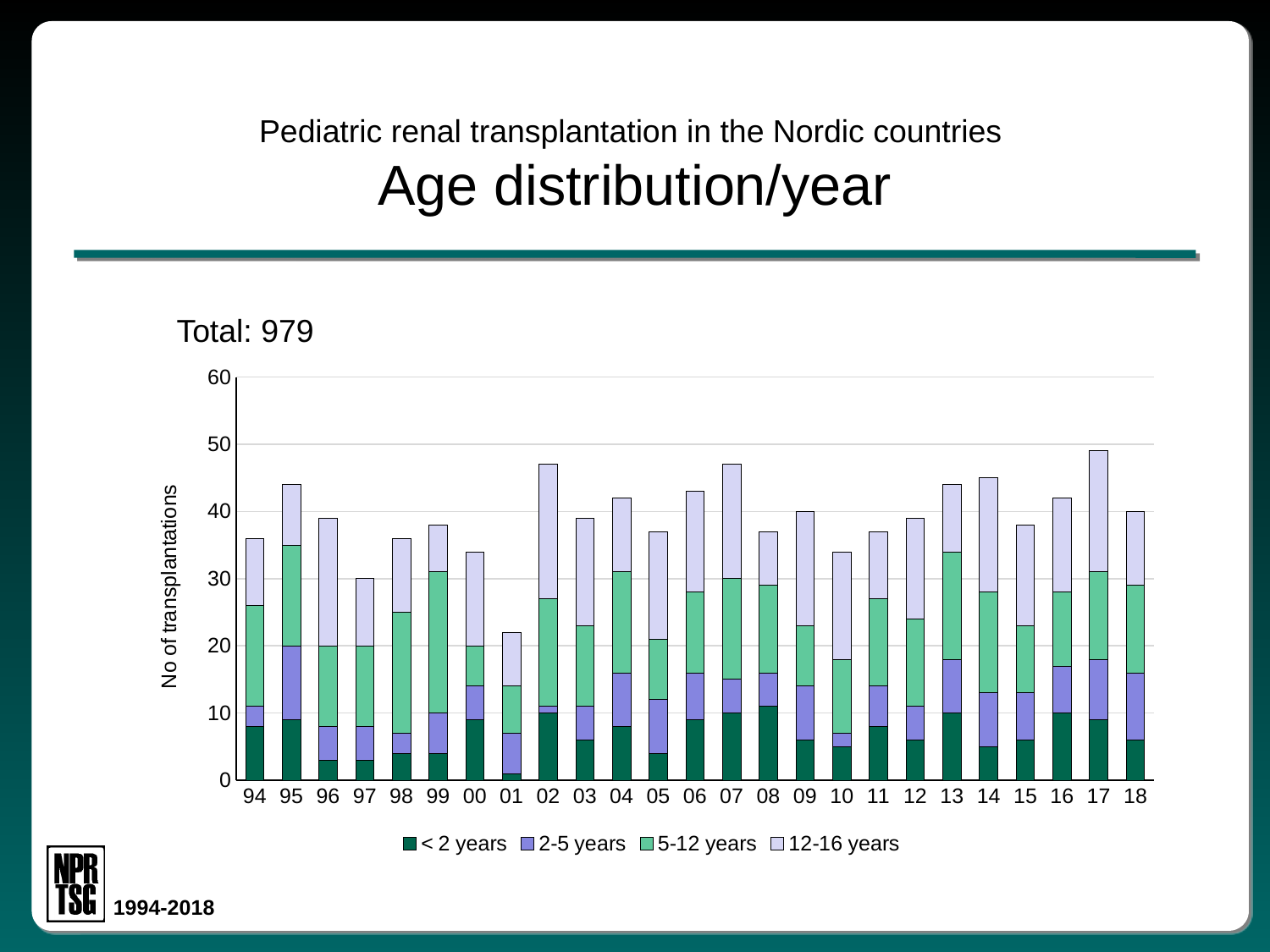
Is the total value for 02 greater or less than 40? greater How many years (bars) are plotted on the x axis? 25 What is the label of the y axis? No of transplantations Which year has the lowest total number of transplantations? 01 Is the total value for 01 greater or less than 30? less Which year has the larger total, 95 or 96? 95 Is the total value for 10 greater or less than 40? less What kind of chart is shown on the slide? Stacked bar chart How many series does the legend list? 4 Which year has the larger total, 01 or 02? 02 What total number of transplantations is stated above the chart? 979